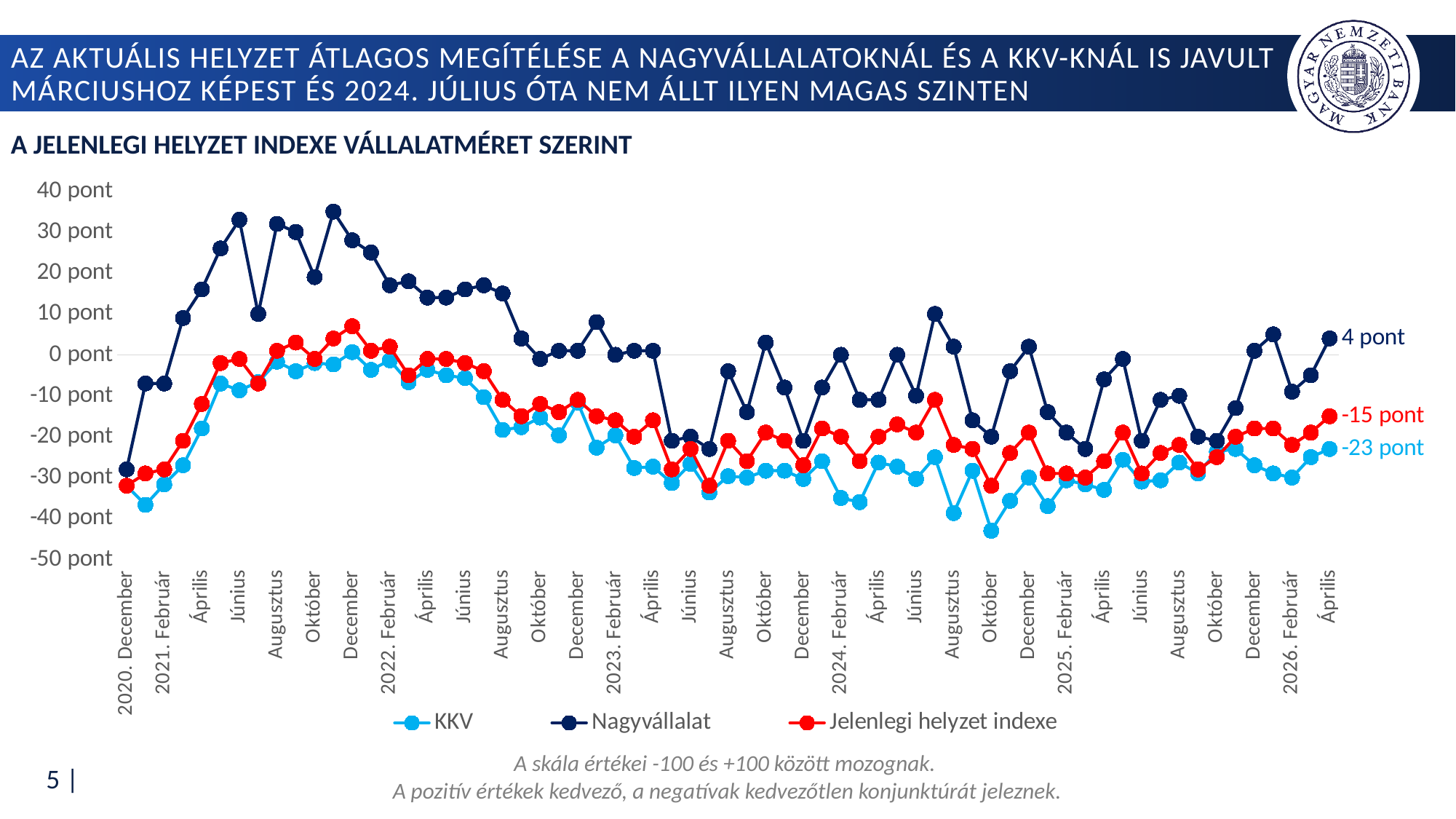
What is the value for Jelenlegi helyzet indexe at the last point (2026. Április)? -15 pont At 2026. Április, which is larger: the Nagyvállalat value or the Jelenlegi helyzet indexe value? Nagyvállalat What kind of chart is shown on the slide? Line chart At 2026. Április, which series has the highest value? Nagyvállalat How many series does the legend list? 3 Is the value for Nagyvállalat at 2021. December greater or less than 30 pont? less At 2026. Április, what is the difference between the Nagyvállalat value and the KKV value? 27 pont What is the value for Nagyvállalat at the last point (2026. Április)? 4 pont At 2026. Április, what is the difference between the Jelenlegi helyzet indexe value and the KKV value? 8 pont At 2026. Április, which series has the lowest value? KKV What is the value for KKV at the last point (2026. Április)? -23 pont Is the value for KKV at 2024. Október greater or less than -40 pont? less